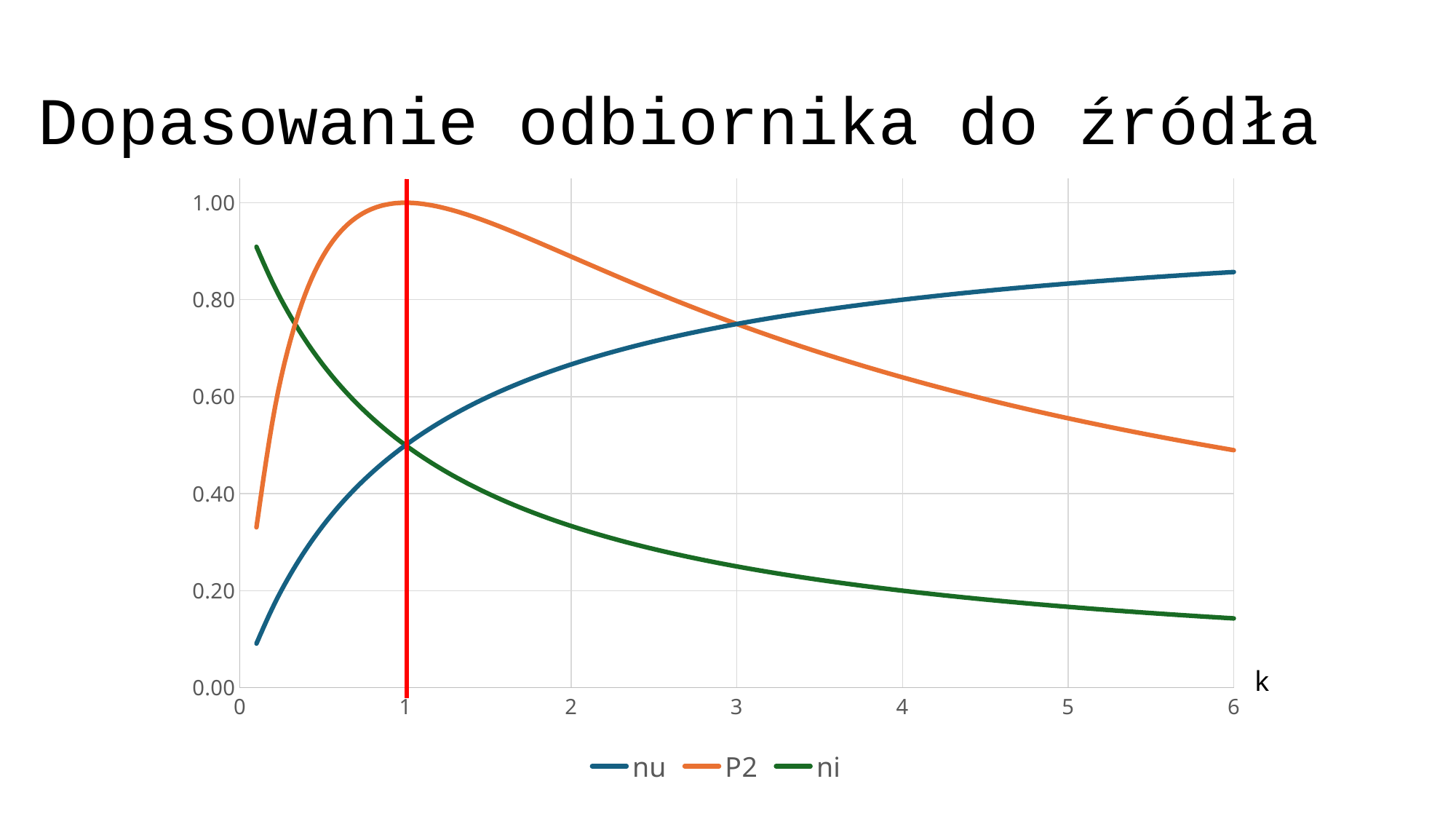
At k = 5, which series has the larger value, nu or P2? nu Does the ni series rise or fall as k increases? fall What is the title of the slide containing the chart? Dopasowanie odbiornika do źródła Is the value of the ni series at k = 6 greater or less than 0.20? less At k = 2, which series has the larger value, P2 or ni? P2 At what value of k does the P2 series reach its maximum? 1 What is the maximum value reached by the P2 series? 1.00 Is the value of the nu series at k = 6 greater or less than 0.80? greater How many series does the legend list? 3 Does the nu series rise or fall as k increases? rise What kind of chart is shown on the slide? line chart What label is shown on the x axis of the chart? k